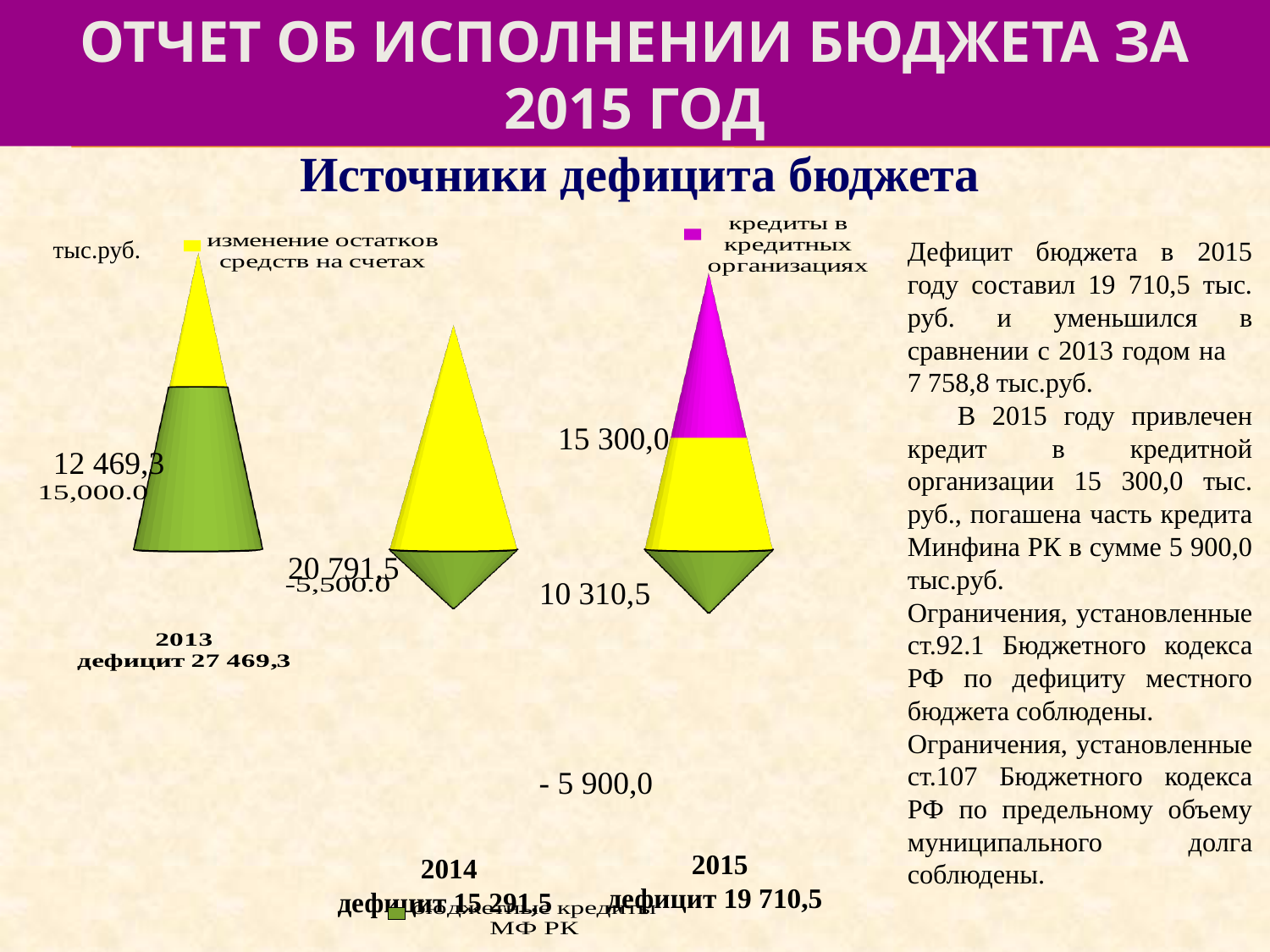
What is the value for 'бюджетные кредиты МФ РК' in 2014? -5,500.0 What kind of chart is shown on the slide? bar chart Which year has the lowest total deficit? 2014 How many series does the chart's legend list? 3 Which year has the highest total deficit? 2013 What is the value for 'бюджетные кредиты МФ РК' in 2015? - 5 900,0 By how much is the 2015 deficit (19 710,5) larger than the 2014 deficit (15 291,5)? 4 419,0 In 2015, which is larger: 'кредиты в кредитных организациях' or 'изменение остатков средств на счетах'? кредиты в кредитных организациях How many years (categories) are shown on the x axis of the chart? 3 What is the total deficit shown for 2013? 27 469,3 What is the value for 'кредиты в кредитных организациях' in 2015? 15 300,0 What is the value for 'изменение остатков средств на счетах' in 2014? 20 791,5